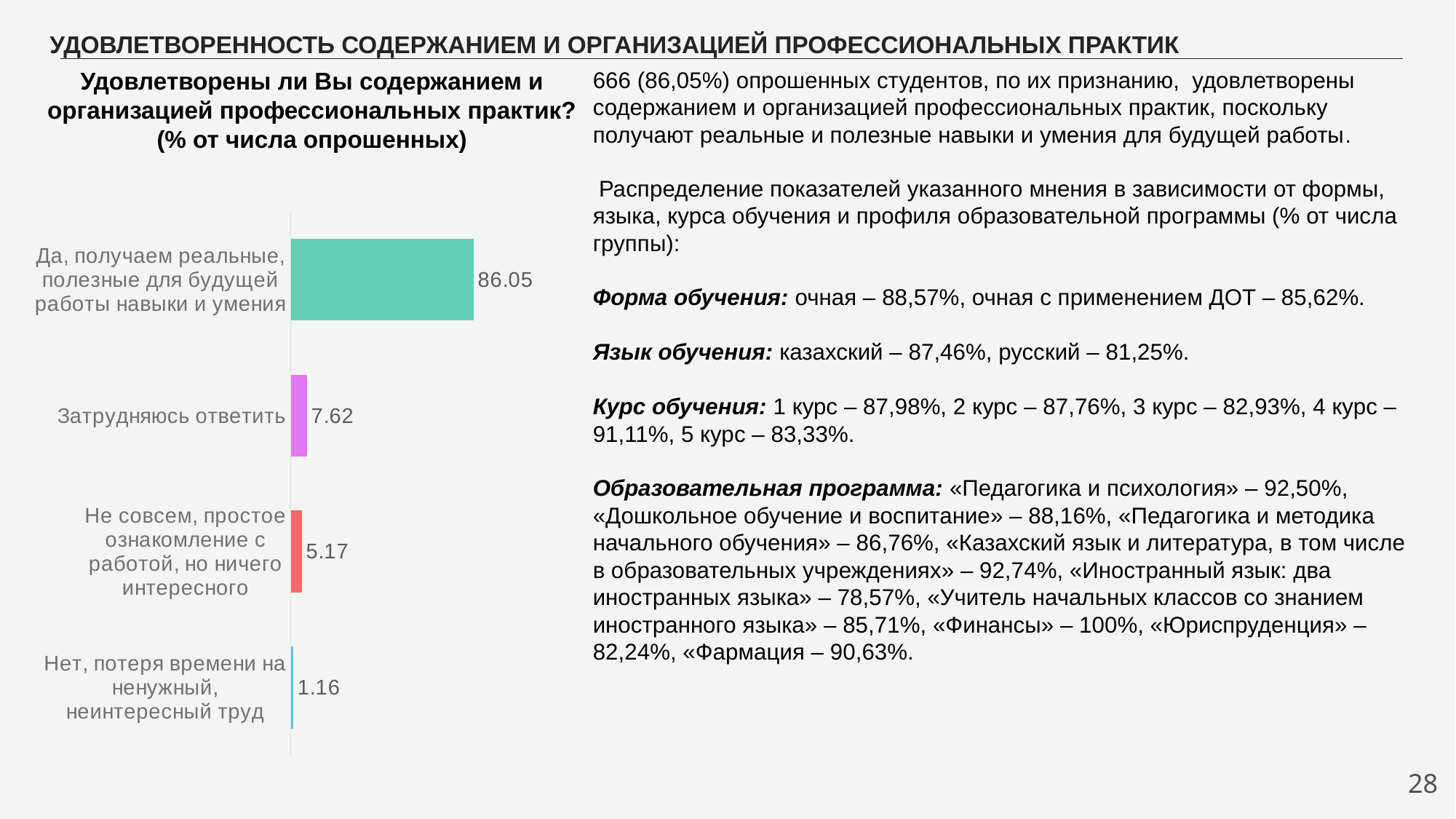
What value is shown for the category "Не совсем, простое ознакомление с работой, но ничего интересного"? 5.17 What is the title of the chart? Удовлетворены ли Вы содержанием и организацией профессиональных практик? (% от числа опрошенных) What value is shown for the category "Нет, потеря времени на ненужный, неинтересный труд"? 1.16 Which is larger: the value for "Затрудняюсь ответить" or the value for "Нет, потеря времени на ненужный, неинтересный труд"? Затрудняюсь ответить What kind of chart is shown on the slide? Bar chart What value is shown for the category "Затрудняюсь ответить"? 7.62 What is the difference between the values for "Затрудняюсь ответить" and "Не совсем, простое ознакомление с работой, но ничего интересного"? 2.45 Which category has the lowest value in the chart? Нет, потеря времени на ненужный, неинтересный труд Which category has the highest value in the chart? Да, получаем реальные, полезные для будущей работы навыки и умения How many categories are shown in the chart? 4 What value is shown for the category "Да, получаем реальные, полезные для будущей работы навыки и умения"? 86.05 What is the difference between the values for "Да, получаем реальные, полезные для будущей работы навыки и умения" and "Затрудняюсь ответить"? 78.43